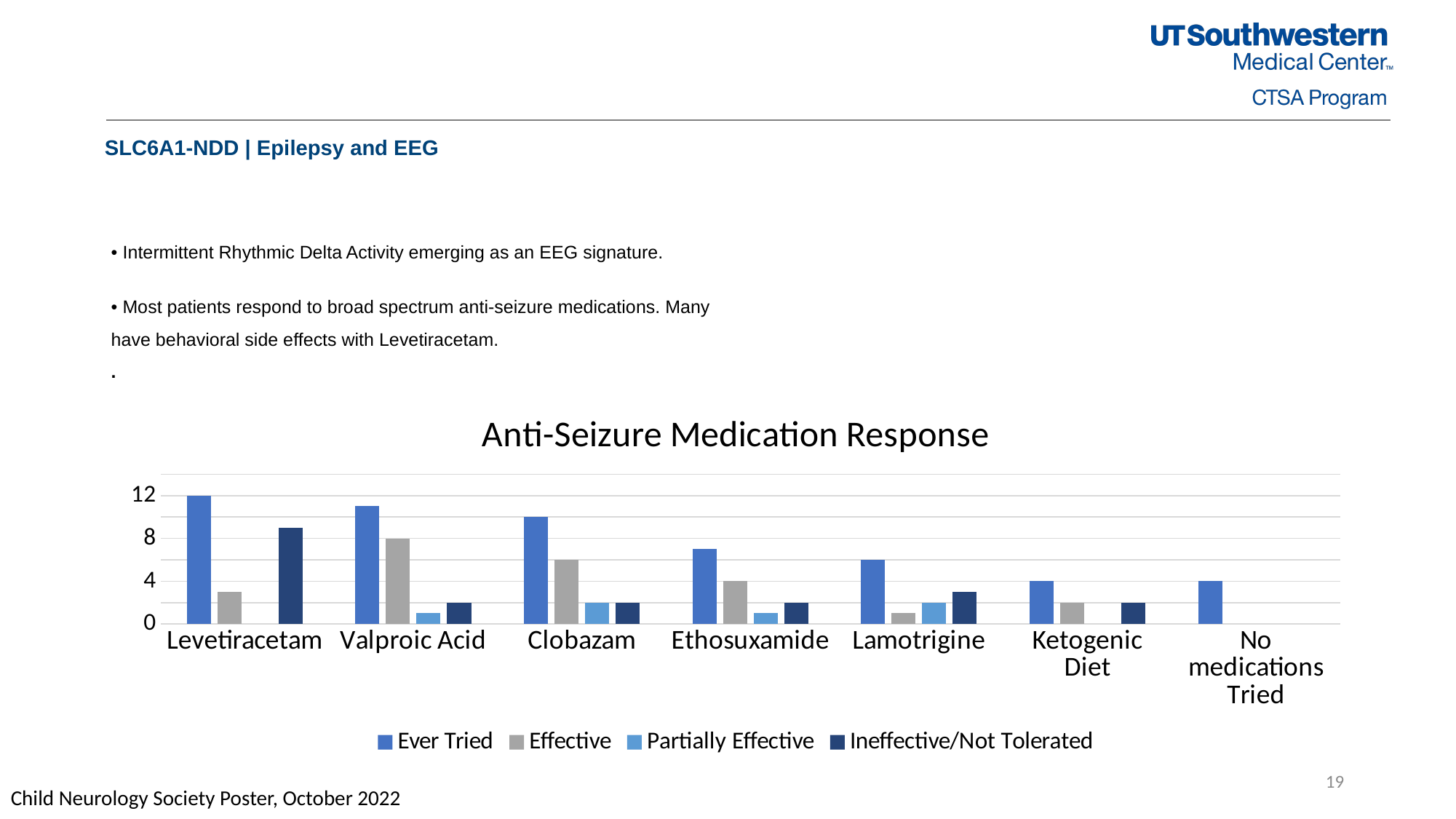
Is the Ever Tried value for Ethosuxamide greater or less than 4? greater What is the title of the chart? Anti-Seizure Medication Response Is the Effective value for Levetiracetam greater or less than 4? less What is the Effective value for Valproic Acid? 8 Which medication has the highest Ever Tried value? Levetiracetam How many series does the chart legend list? 4 What type of chart is shown on the slide? Bar chart What is the Ever Tried value for Ketogenic Diet? 4 What is the Ever Tried value for Levetiracetam? 12 Which is larger: the Ineffective/Not Tolerated value for Levetiracetam or for Valproic Acid? Levetiracetam Is the Ever Tried value for Clobazam greater or less than 8? greater How many categories are shown along the x axis of the chart? 7